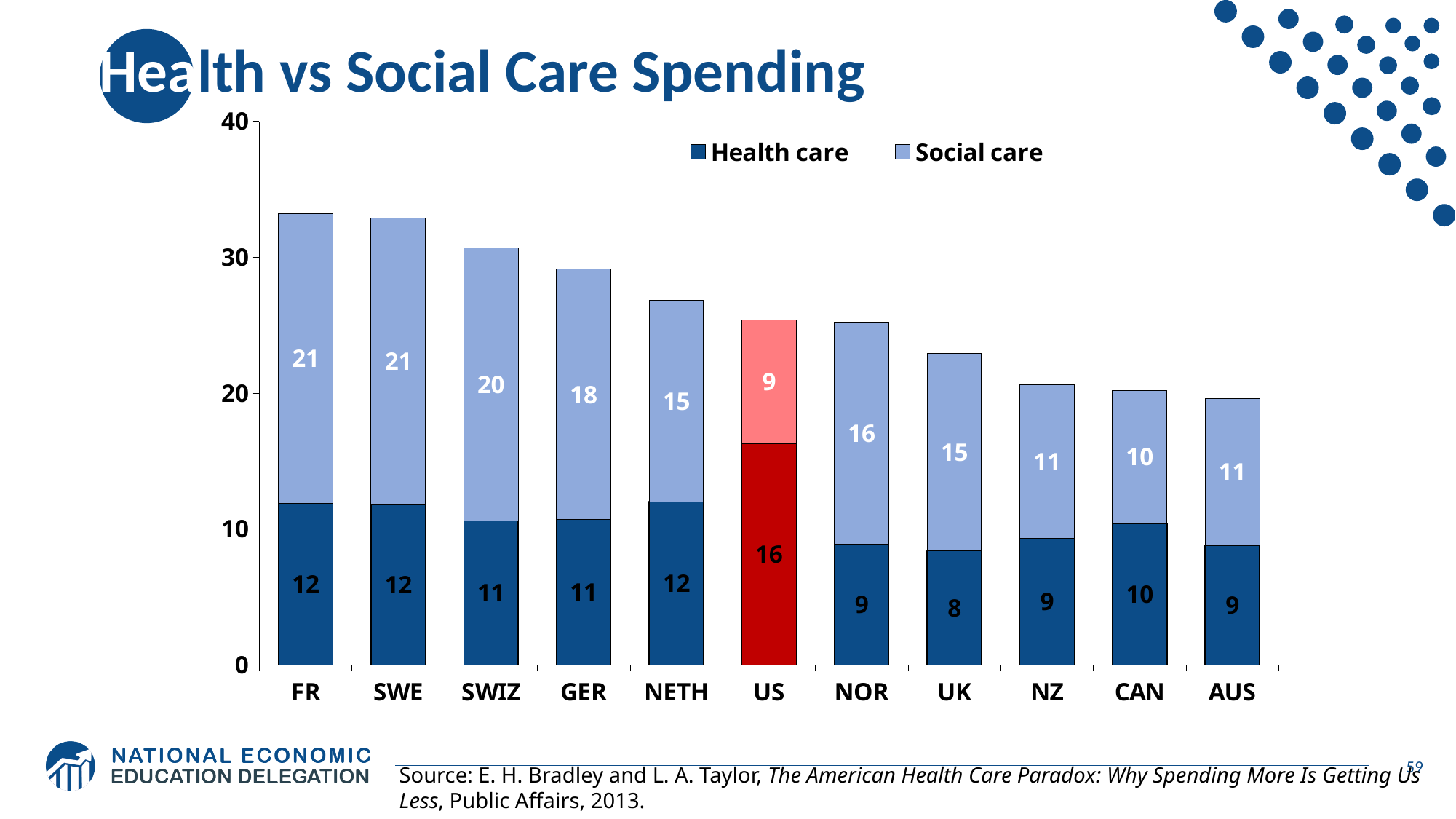
Which country has the lowest Health care value? UK Which is larger, the Social care value for GER or for NETH? GER Which country has the highest Health care value? US Which country has the lowest Social care value? US What is the total of the stacked bar for the US? 25 How many series does the legend list? 2 What is the Health care value for the US? 16 How many countries are shown on the x axis? 11 What is the Social care value for NOR? 16 Which country's bar is coloured red instead of blue? US What kind of chart is shown on the slide? Stacked bar chart What is the difference between the Social care and Health care values for FR? 9